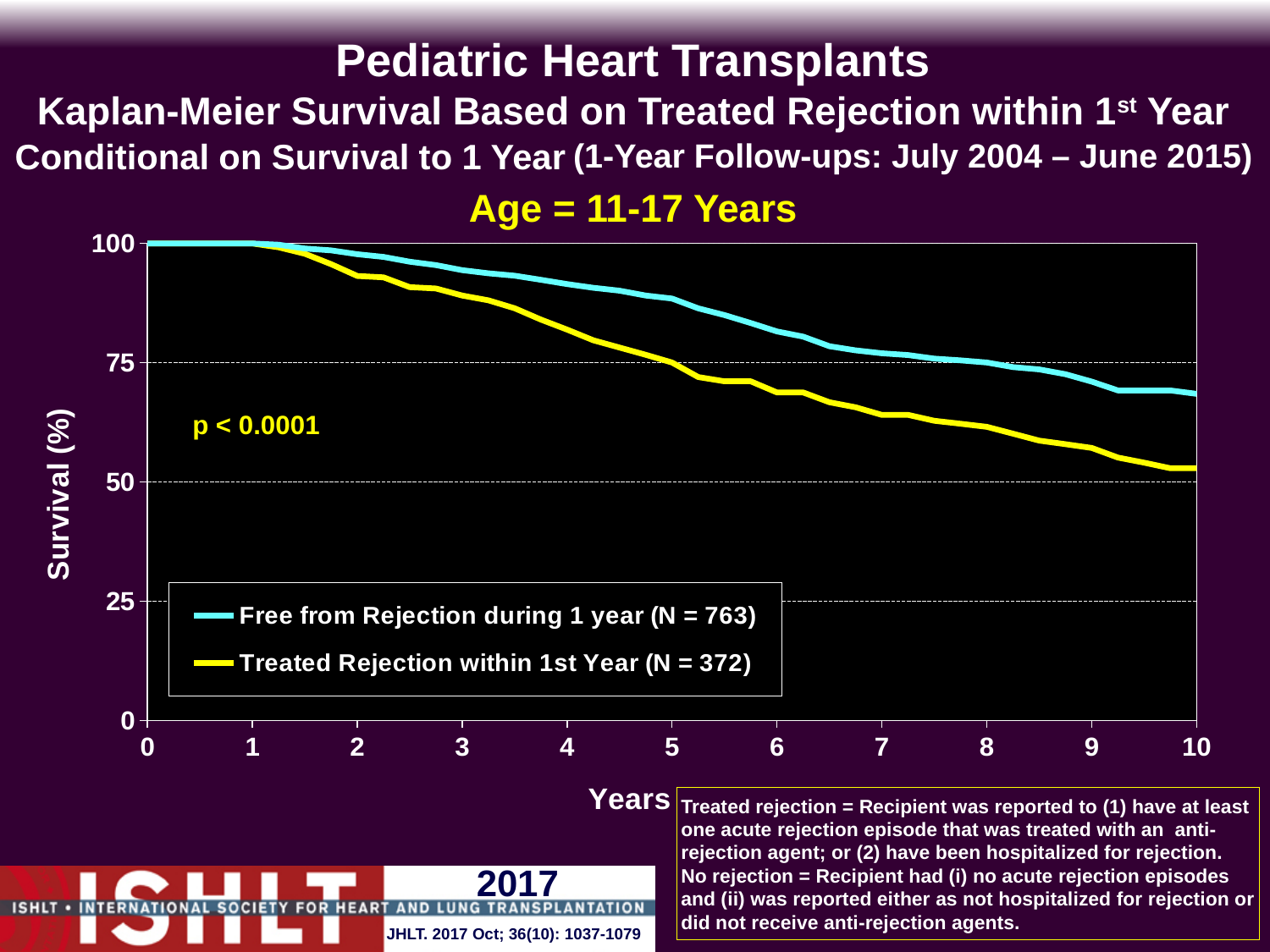
At year 5, which series has the higher survival: Free from Rejection during 1 year or Treated Rejection within 1st Year? Free from Rejection during 1 year Do the survival curves rise or fall as years increase? Fall How many series does the legend list? 2 What is the N for the Treated Rejection within 1st Year series in the legend? 372 What kind of chart is shown on the slide? Line chart Is the survival value for Treated Rejection within 1st Year at year 10 greater or less than 75? less Is the survival value for Free from Rejection during 1 year at year 10 greater or less than 50? greater Is the survival value for Free from Rejection during 1 year at year 5 greater or less than 75? greater What p-value is printed on the chart? p < 0.0001 What is the maximum value shown on the x axis (Years)? 10